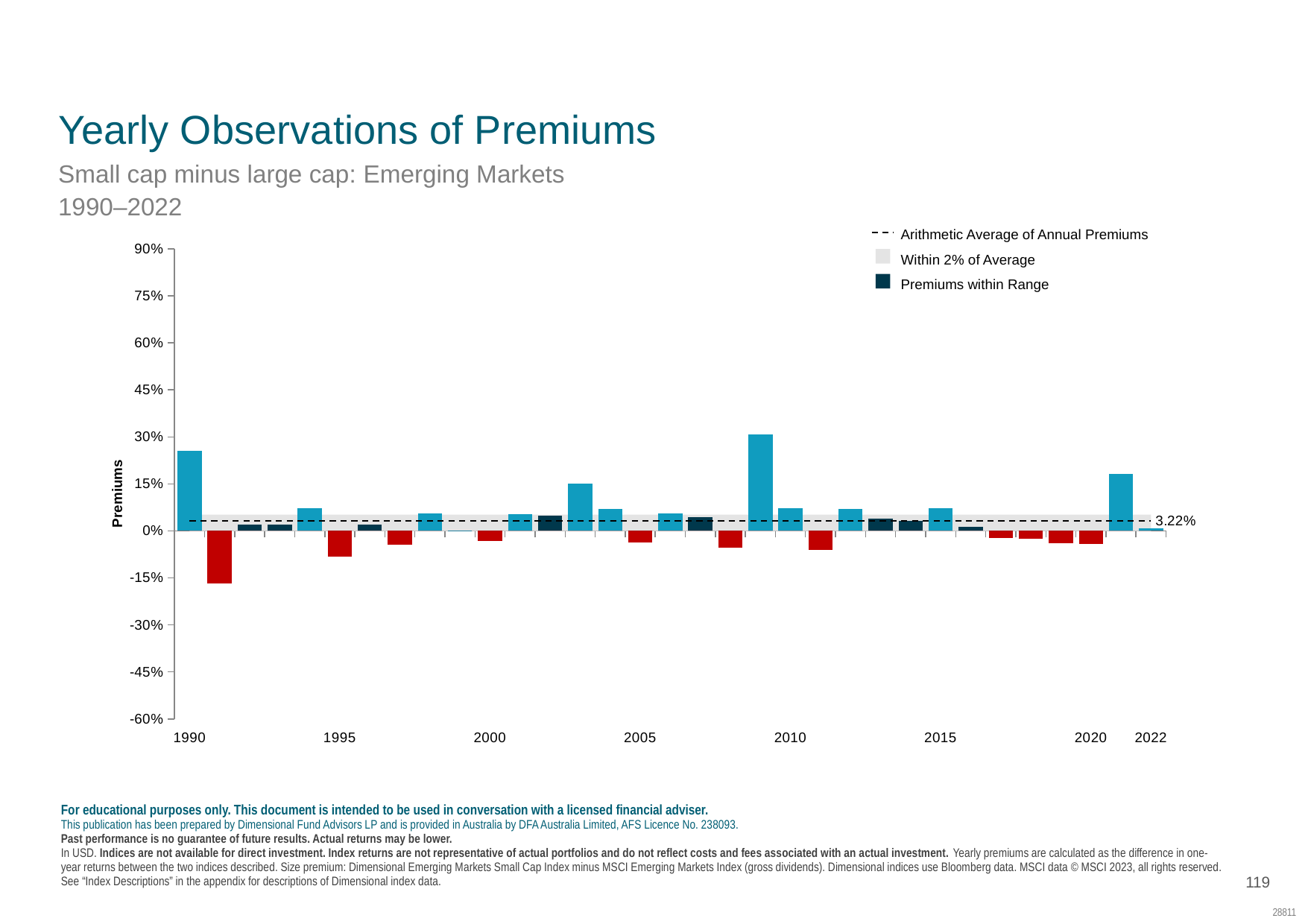
How many entries does the chart legend list? 3 What kind of chart is shown on the slide? bar chart What is the label on the vertical axis of the chart? Premiums Among the years labelled on the x axis, which has the highest premium? 1990 Is the premium for 1990 greater or less than 15%? greater How many yearly bars are plotted on the chart (1990 through 2022)? 33 Is the premium for 2020 greater or less than 0%? less Is the premium for 1995 greater or less than 0%? less Among the years labelled on the x axis, which has the lowest premium? 1995 Which has the larger premium, 1990 or 1995? 1990 What is the value of the arithmetic average of annual premiums shown on the chart? 3.22%